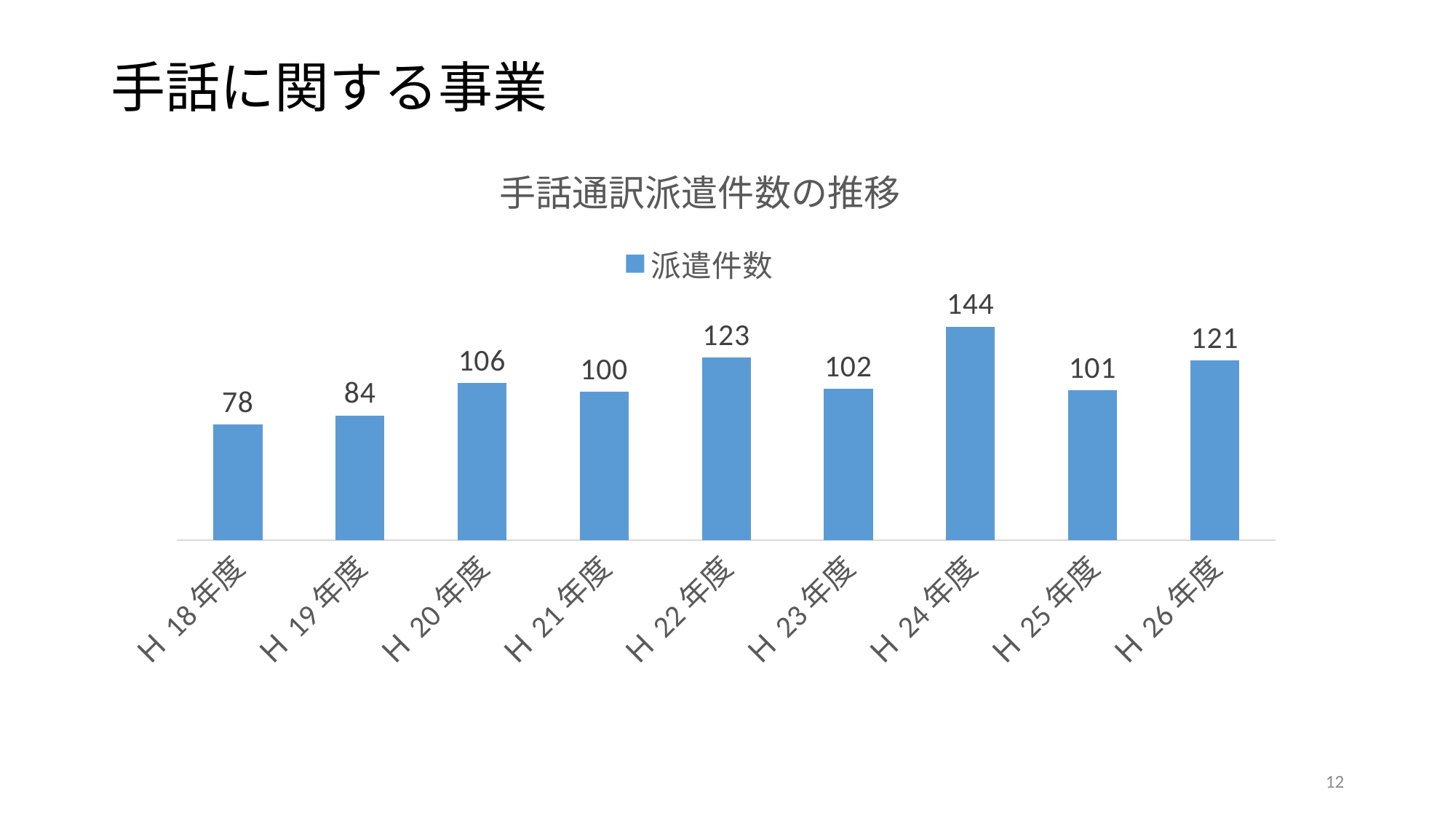
What kind of chart is shown? bar chart How many years are shown on the x axis? 9 What is the difference between the values for H 24年度 and H 25年度? 43 Which is larger, the value for H 22年度 or the value for H 23年度? H 22年度 What is the value for H 24年度? 144 What is the value for H 18年度? 78 Which year has the highest 派遣件数? H 24年度 What is the difference between the values for H 19年度 and H 18年度? 6 What is the value for H 26年度? 121 What is the title of the chart? 手話通訳派遣件数の推移 How many series does the legend list? 1 Which year has the lowest 派遣件数? H 18年度